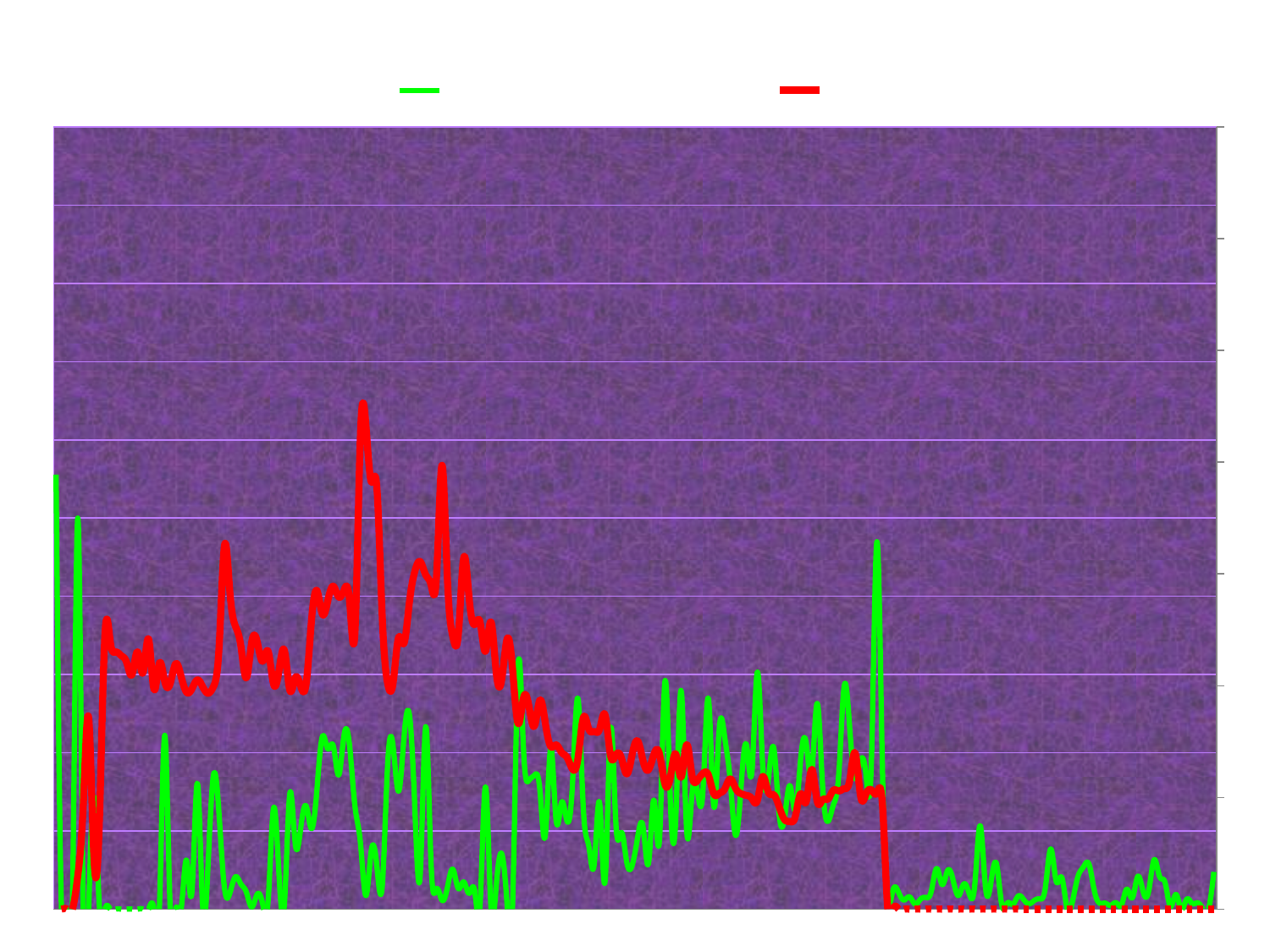
How many series does the legend list? 2 Over the right half of the chart, does the red line generally rise or fall? fall Which line reaches the highest point on the chart, the green line or the red line? the red line Which line is at the bottom of the chart (at zero) across the far right portion of the x axis? the red line What colours are the two lines plotted on the chart? green and red What kind of chart is shown on the slide? line chart